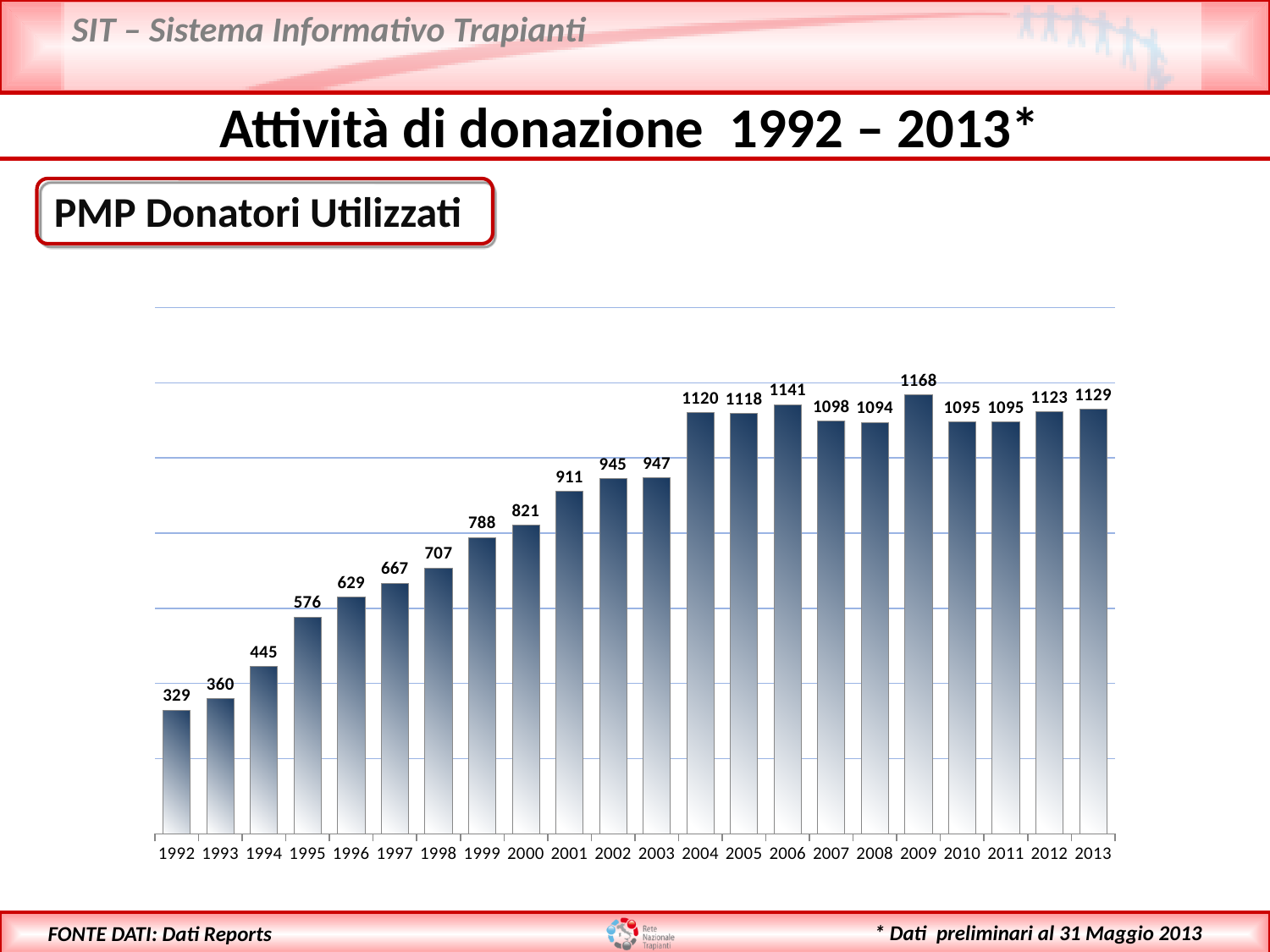
What is the difference between the values for 2013 and 1992? 800 How many years are shown on the x axis? 22 What is the value for 2001? 911 Which year has the lowest value? 1992 Which year has the highest value? 2009 What is the value for 2009? 1168 What is the difference between the values for 2009 and 2008? 74 What is the value for 1992? 329 What is the label in the box above the chart? PMP Donatori Utilizzati What kind of chart is this? bar chart Which is larger, the value for 1999 or the value for 2000? 2000 Do the values generally rise or fall from 1992 to 2004? rise